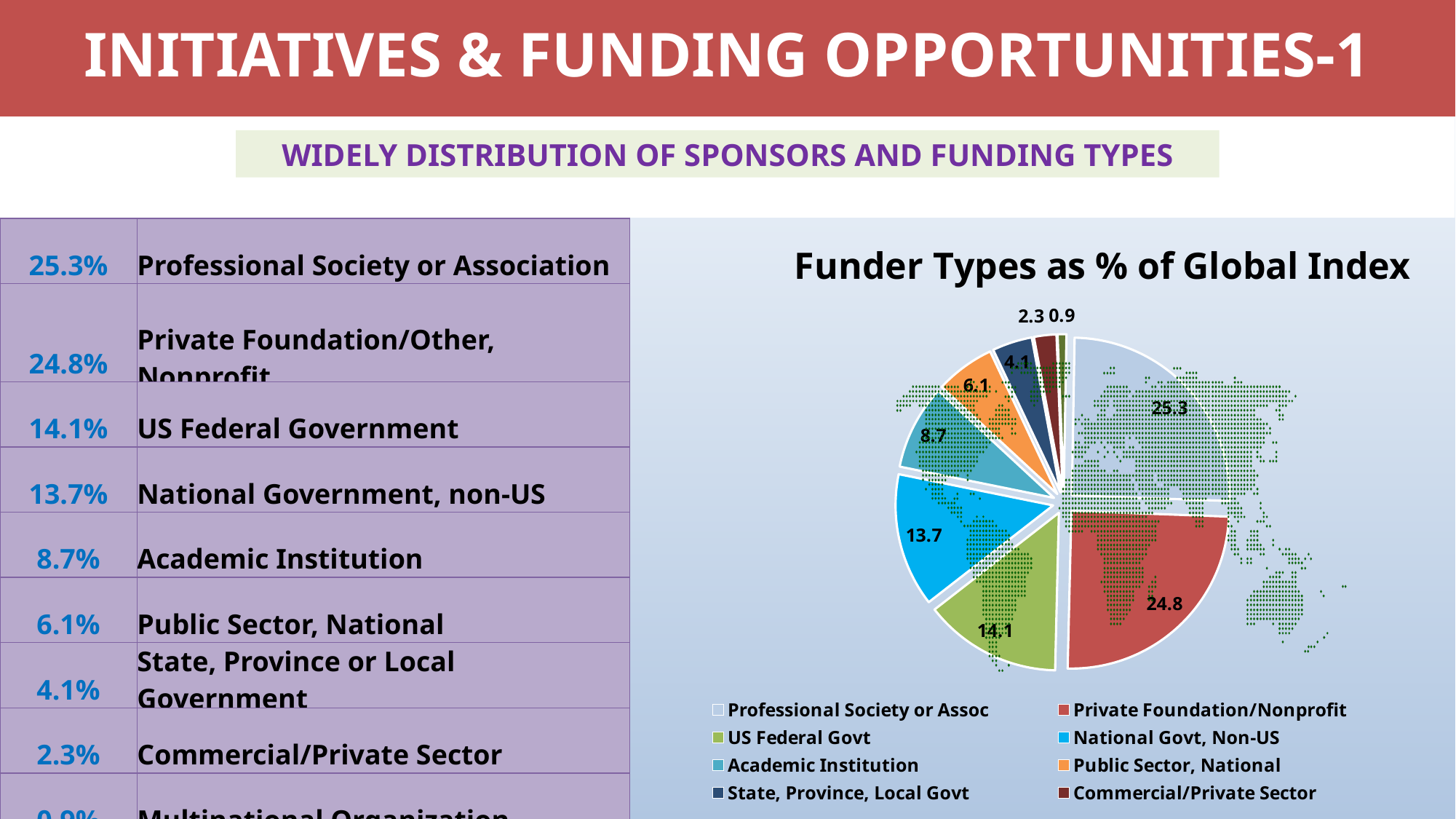
How many entries does the chart legend list? 8 What value is shown for US Federal Govt in the pie chart? 14.1 Which funder type has the largest slice of the pie chart? Professional Society or Assoc What value is shown for Private Foundation/Nonprofit in the pie chart? 24.8 What kind of chart is shown on the slide? pie chart What value is shown for State, Province, Local Govt in the pie chart? 4.1 What value is shown for Professional Society or Assoc in the pie chart? 25.3 What is the difference between the values for US Federal Govt and National Govt, Non-US? 0.4 Which is larger in the pie chart: Public Sector, National or State, Province, Local Govt? Public Sector, National What is the difference between the values for Academic Institution and Commercial/Private Sector? 6.4 What value is shown for Academic Institution in the pie chart? 8.7 What is the title of the chart? Funder Types as % of Global Index